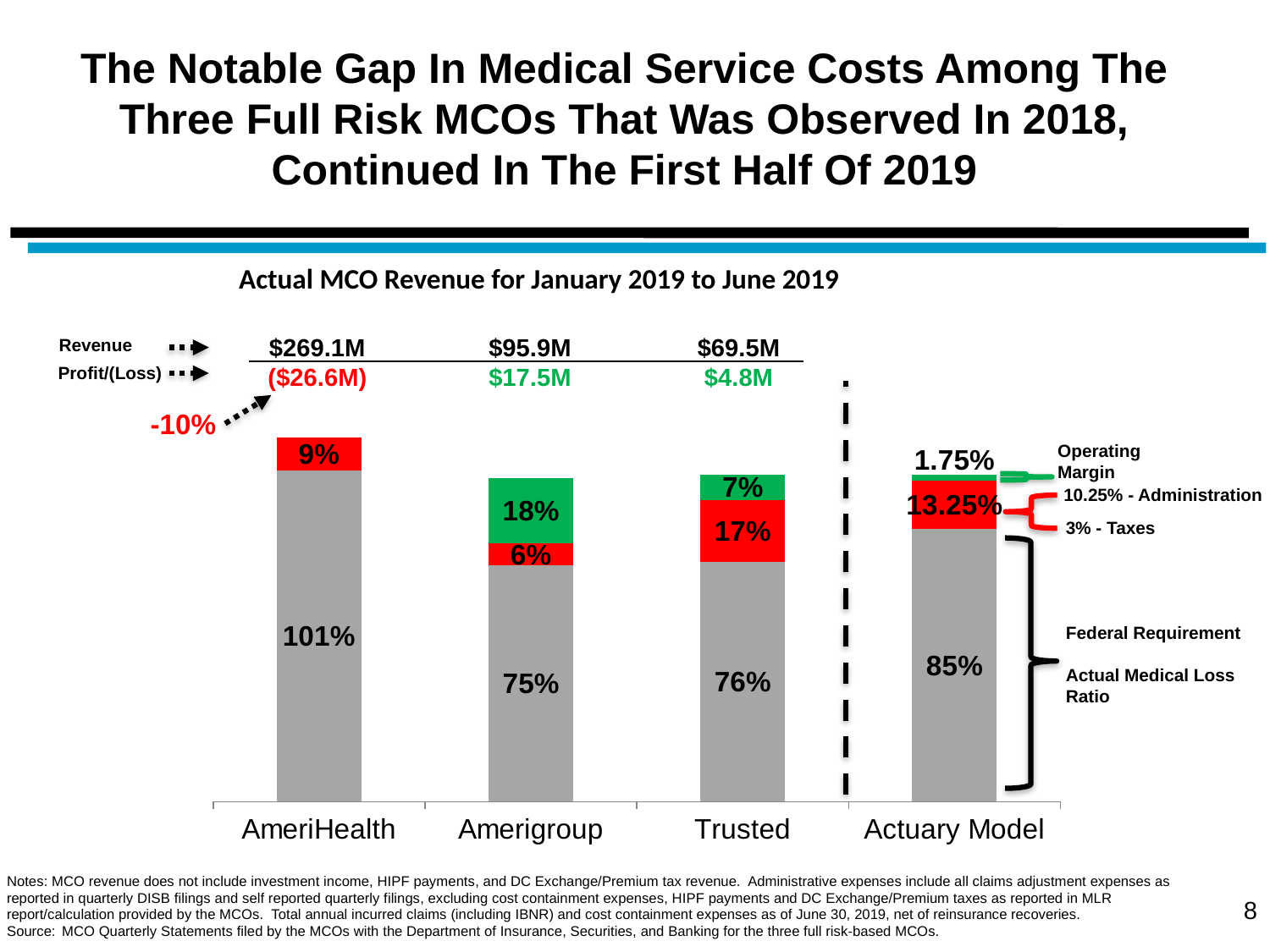
Which has a larger green segment, Amerigroup or Trusted? Amerigroup What is the difference between the gray segment values for AmeriHealth and Trusted? 25% What revenue is shown above the Amerigroup bar? $95.9M What is the medical loss ratio (gray segment) for AmeriHealth? 101% What is the gray segment value for Amerigroup? 75% What kind of chart is shown on the slide? Stacked bar chart What is the title of the chart? Actual MCO Revenue for January 2019 to June 2019 What is the green segment value for the Actuary Model? 1.75% How many categories are shown on the x axis of the chart? 4 Which category has the highest gray segment value? AmeriHealth What is the red segment value for Trusted? 17% Which category has the lowest gray segment value? Amerigroup